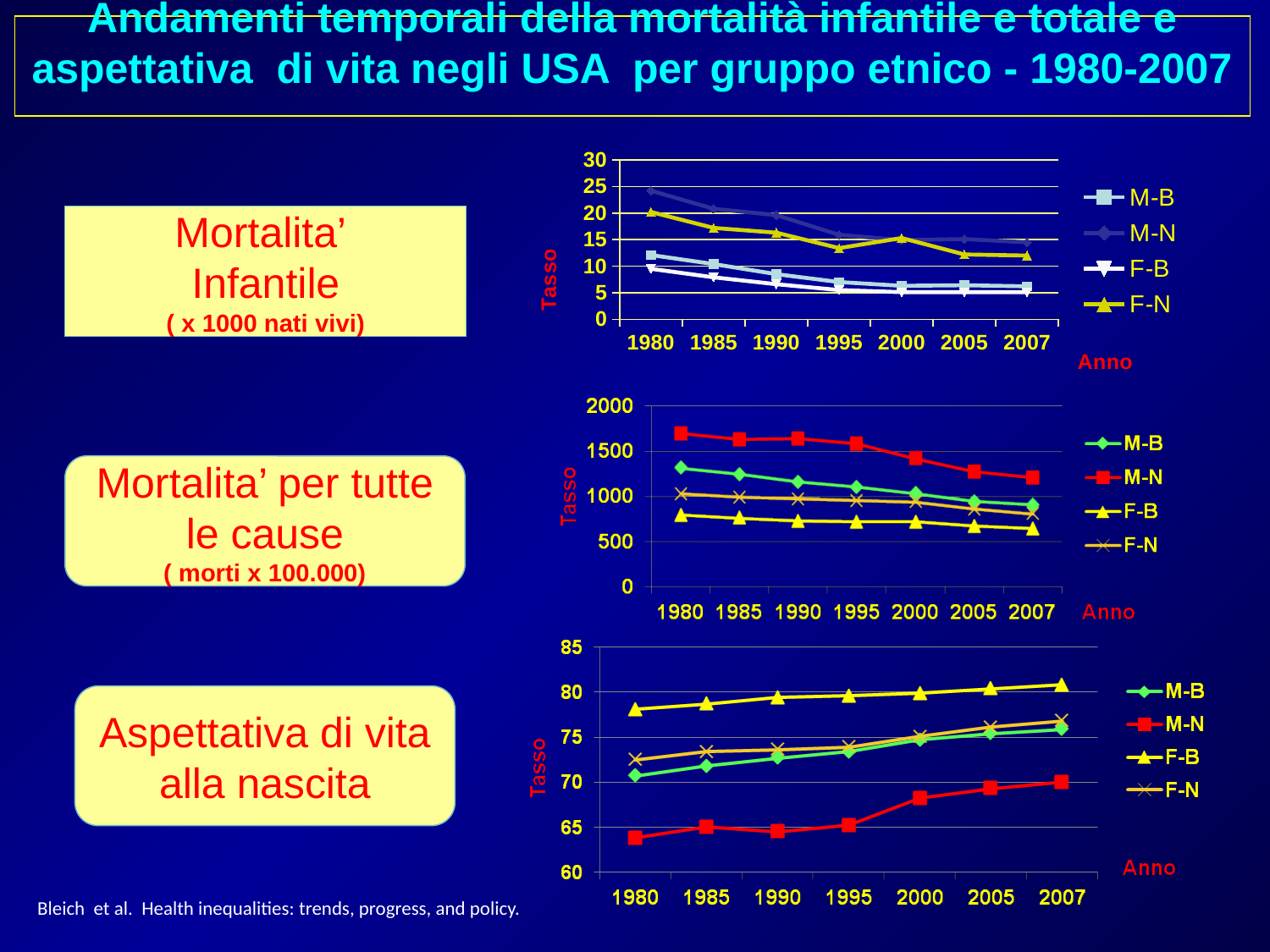
In the 'Mortalita' Infantile' chart, do the values for F-N rise or fall from 1980 to 2007? fall In the 'Mortalita' per tutte le cause' chart, which series has the lowest values across all years? F-B In the 'Aspettativa di vita alla nascita' chart, is the value for M-N in 1980 greater or less than 65? less How many series does the legend of the 'Mortalita' Infantile' chart list? 4 In the 'Mortalita' Infantile' chart, is the value for M-N in 1980 greater or less than 20? greater In the 'Mortalita' per tutte le cause' chart, is the value for M-N in 1980 greater or less than 1500? greater In the 'Aspettativa di vita alla nascita' chart, which series has the highest values across all years? F-B In the 'Mortalita' per tutte le cause' chart, which is larger in 2007: M-B or F-B? M-B How many years are plotted on the x axis of the 'Mortalita' per tutte le cause' chart? 7 What kind of chart is the 'Mortalita' Infantile' chart? line chart In the 'Aspettativa di vita alla nascita' chart, do the values for M-B rise or fall from 1980 to 2007? rise In the 'Mortalita' Infantile' chart, which series has the highest value in 1980? M-N